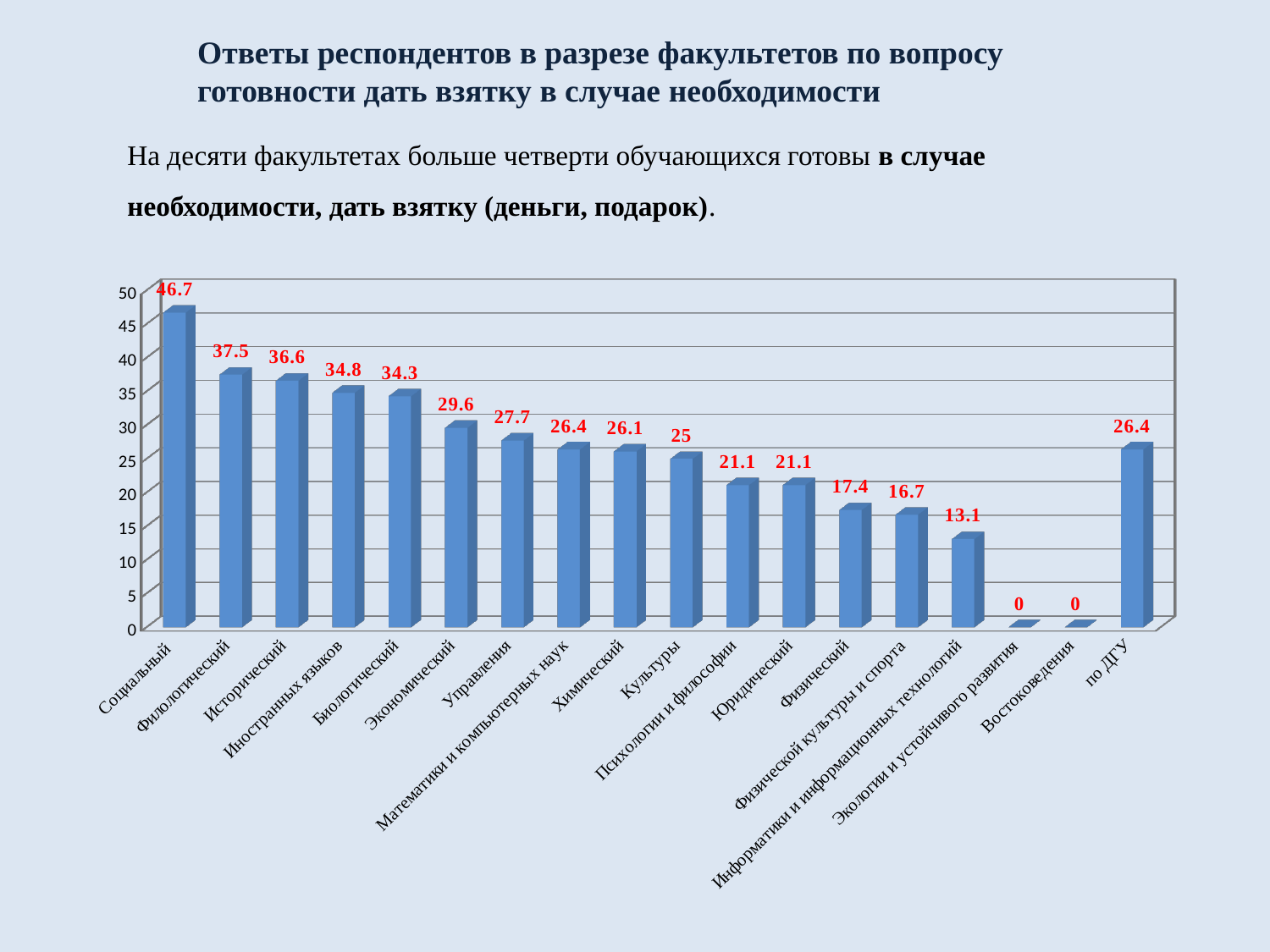
What kind of chart is shown on the slide? bar chart What is the value for по ДГУ? 26.4 Which is larger, the value for Исторический or the value for Биологический? Исторический Is the value for Управления greater or less than 25? greater What is the difference between the values for Физический and Физической культуры и спорта? 0.7 What is the value for Экономический? 29.6 What is the value for Информатики и информационных технологий? 13.1 Which two faculties have a value of 0? Экологии и устойчивого развития and Востоковедения How many bars (categories) are shown on the chart? 18 What is the difference between the values for Социальный and Филологический? 9.2 Which faculty has the highest value? Социальный What is the value for Социальный? 46.7